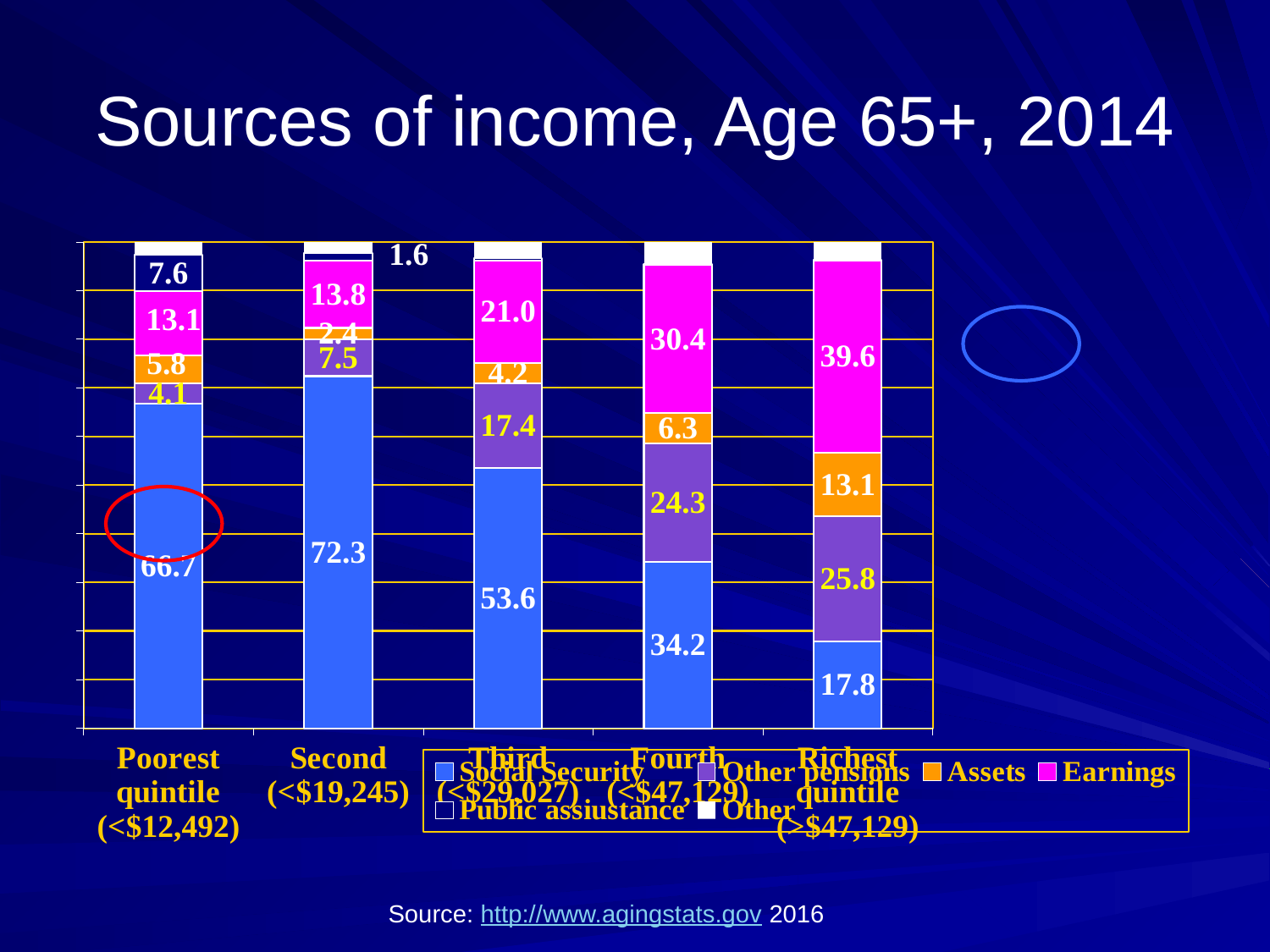
How many income quintiles (bars) are plotted in the chart? 5 How many series does the legend list? 6 Does the Earnings value rise or fall moving from the Second quintile to the Richest quintile? Rise What is the Other pensions value for the Third quintile? 17.4 What kind of chart is shown on the slide? Stacked bar chart What is the Earnings value for the Richest quintile? 39.6 What is the Social Security value for the Second quintile? 72.3 Which quintile has the highest Social Security value? Second Which quintile has the lowest Social Security value? Richest quintile What is the difference between the Earnings values for the Richest quintile and the Fourth quintile? 9.2 Which is larger, the Other pensions value for the Fourth quintile or for the Richest quintile? Richest quintile What is the Assets value for the Fourth quintile? 6.3